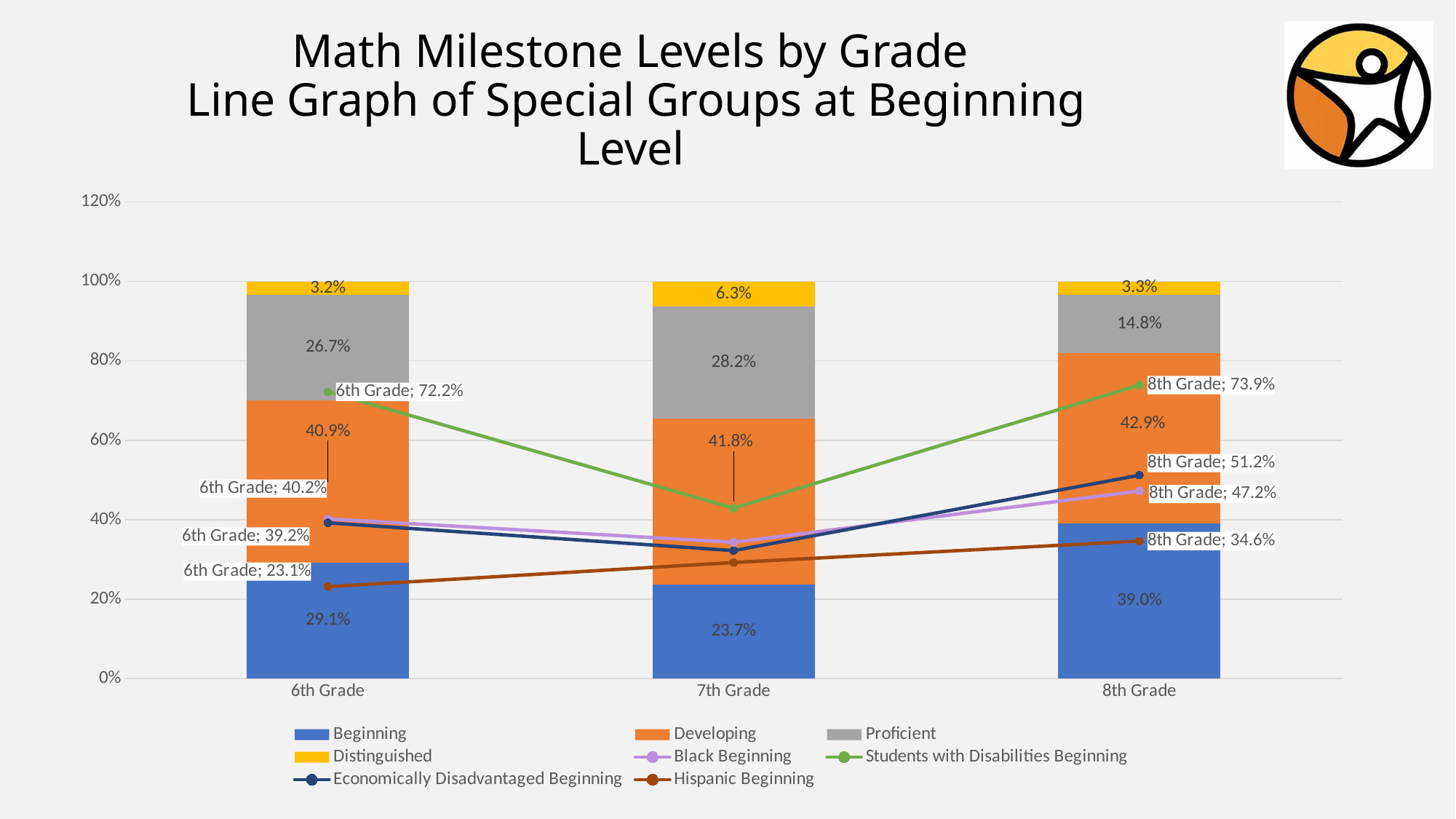
How many series does the legend list? 8 For 8th Grade, which is larger: the Economically Disadvantaged Beginning value or the Black Beginning value? Economically Disadvantaged Beginning Which grade has the lowest Beginning percentage in the stacked bars? 7th Grade What is the difference between the Developing percentage for 8th Grade and for 6th Grade? 2.0 percentage points What is the Hispanic Beginning value for 6th Grade? 23.1% Is the Students with Disabilities Beginning value for 7th Grade greater or less than 60%? less Which grade has the highest Proficient percentage? 7th Grade What percentage of 8th Grade students are at the Beginning level? 39.0% What is the Students with Disabilities Beginning value for 8th Grade? 73.9% Does the Hispanic Beginning line rise or fall from 6th Grade to 8th Grade? rise How many grade levels are shown on the x axis? 3 What is the Distinguished percentage for 7th Grade? 6.3%